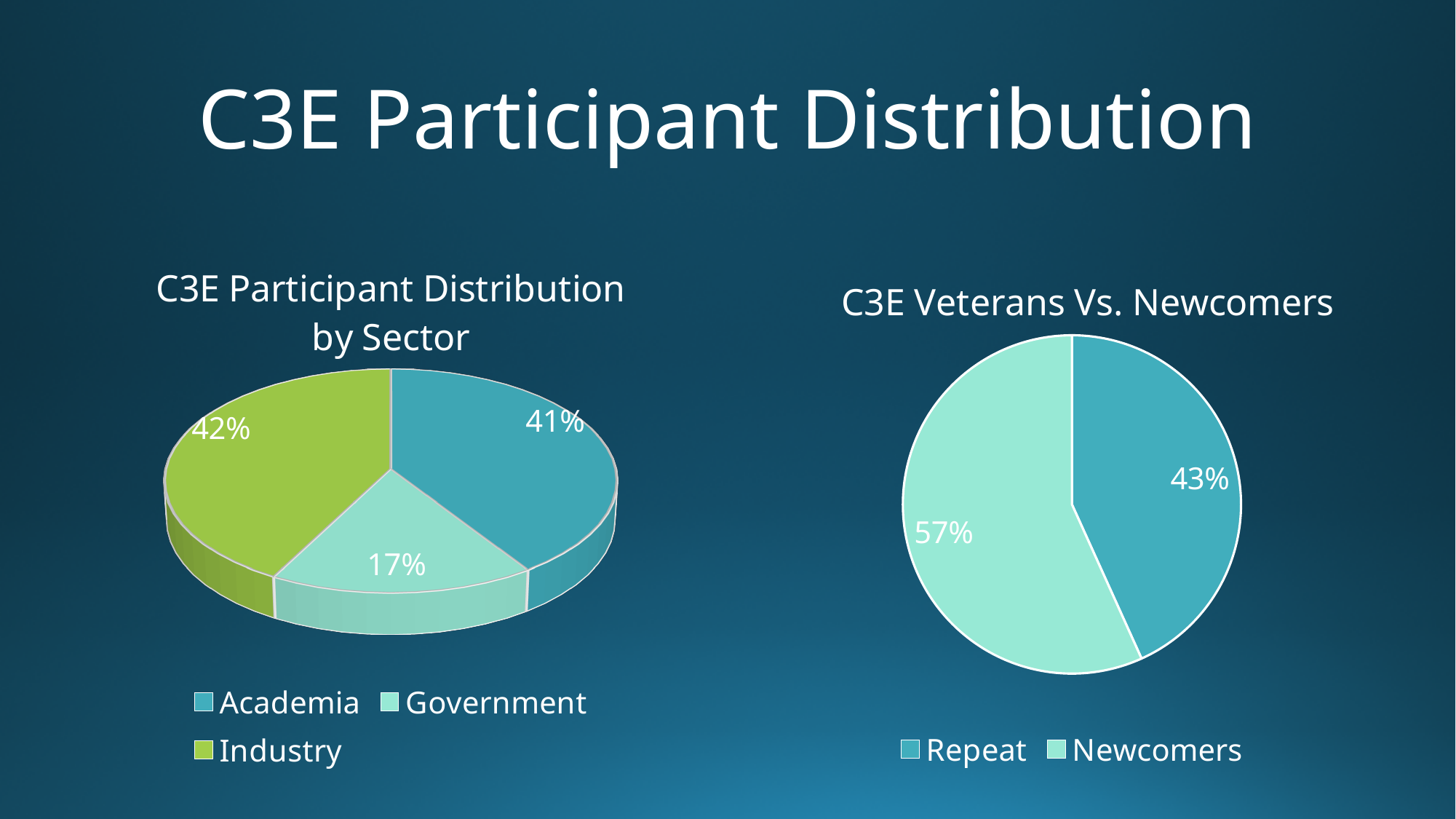
In the 'C3E Veterans Vs. Newcomers' chart, which group is larger, Repeat or Newcomers? Newcomers In the 'C3E Veterans Vs. Newcomers' chart, how many entries does the legend list? 2 In the 'C3E Veterans Vs. Newcomers' chart, what is the difference in percentage points between Newcomers and Repeat? 14 In the 'C3E Veterans Vs. Newcomers' chart, what share of participants are Newcomers? 57% In the 'C3E Participant Distribution by Sector' chart, what share of participants is from Academia? 41% In the 'C3E Participant Distribution by Sector' chart, which sector has the smallest share? Government In the 'C3E Veterans Vs. Newcomers' chart, what share of participants are Repeat? 43% In the 'C3E Participant Distribution by Sector' chart, what is the difference in percentage points between Industry and Government? 25 In the 'C3E Participant Distribution by Sector' chart, what share of participants is from Industry? 42% What kind of chart is 'C3E Participant Distribution by Sector'? Pie chart In the 'C3E Participant Distribution by Sector' chart, what share of participants is from Government? 17% In the 'C3E Participant Distribution by Sector' chart, how many sectors are shown? 3